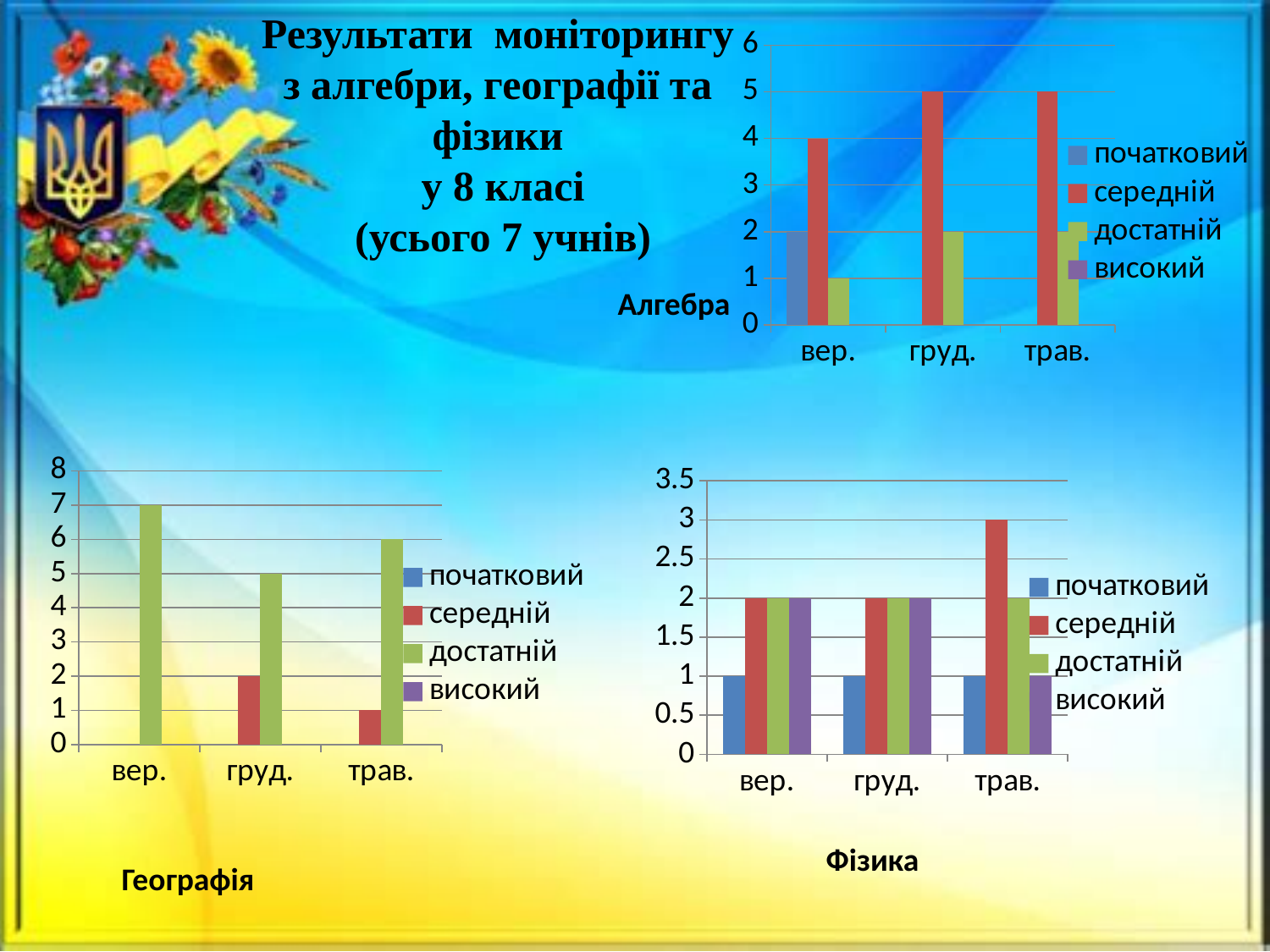
In the Географія chart, what is the value for достатній in вер.? 7 In the Географія chart, what is the difference between достатній in вер. and достатній in груд.? 2 In the Алгебра chart, which month has the lowest value for середній? вер. In the Фізика chart, what is the value for середній in трав.? 3 In the Фізика chart, how many categories are shown on the x axis? 3 What kind of chart is the Географія chart? bar chart In the Алгебра chart, how many series does the legend list? 4 In the Географія chart, what is the value for середній in груд.? 2 In the Алгебра chart, what is the value for початковий in вер.? 2 In the Алгебра chart, what is the value for середній in вер.? 4 In the Фізика chart, which is larger in трав.: середній or високий? середній In the Географія chart, which month has the highest value for достатній? вер.